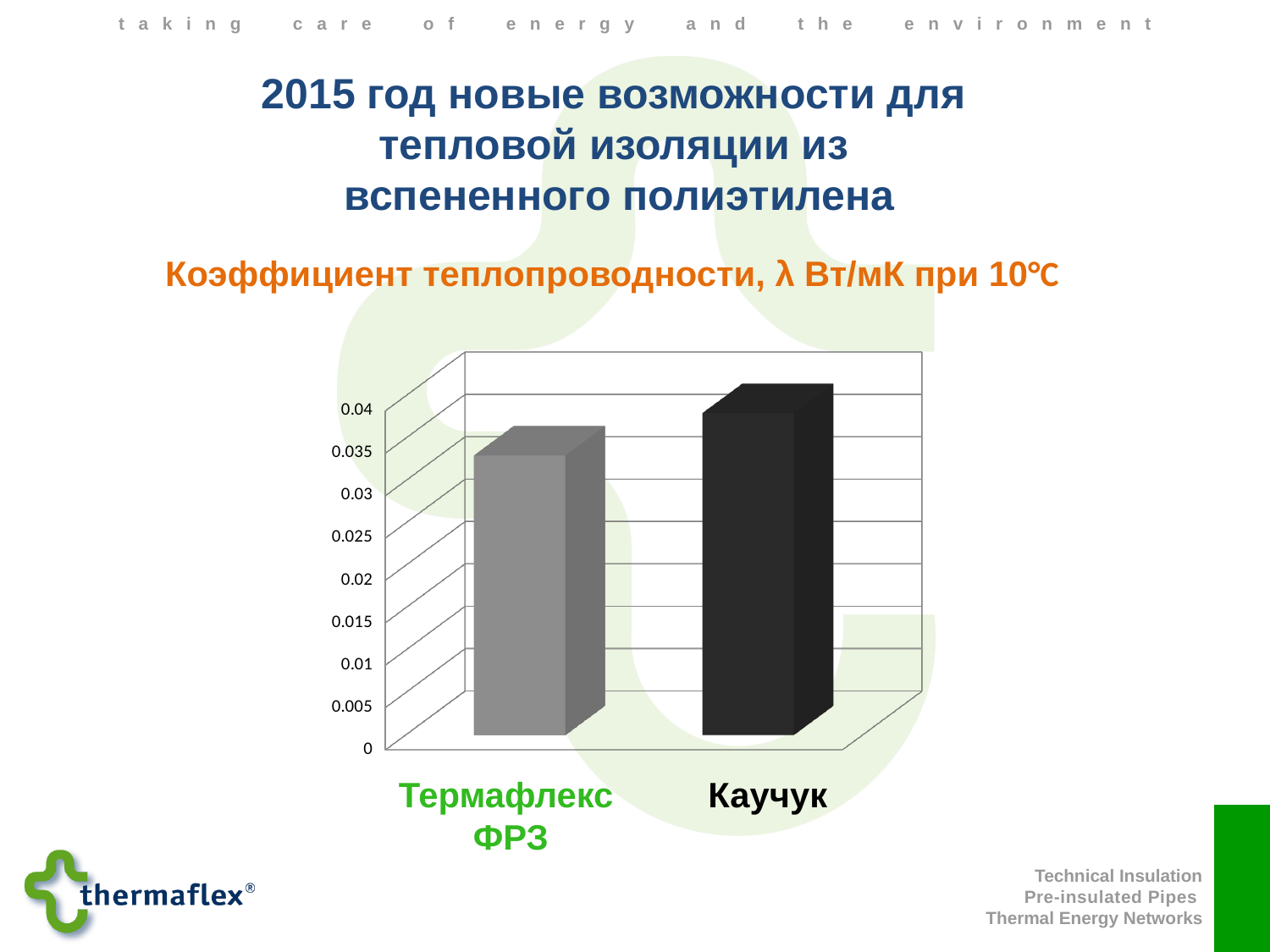
Is the value for Термафлекс ФРЗ greater or less than 0.04? less What kind of chart is shown on the slide? bar chart Which category has the highest value in the chart? Каучук What colour is the bar for Каучук? black Which category has the lowest value in the chart? Термафлекс ФРЗ Is the value for Каучук greater or less than 0.035? greater What is the title of the chart? Коэффициент теплопроводности, λ Вт/мК при 10℃ Which has the larger value, Термафлекс ФРЗ or Каучук? Каучук Is the value for Термафлекс ФРЗ greater or less than 0.03? greater How many categories (bars) are plotted in the chart? 2